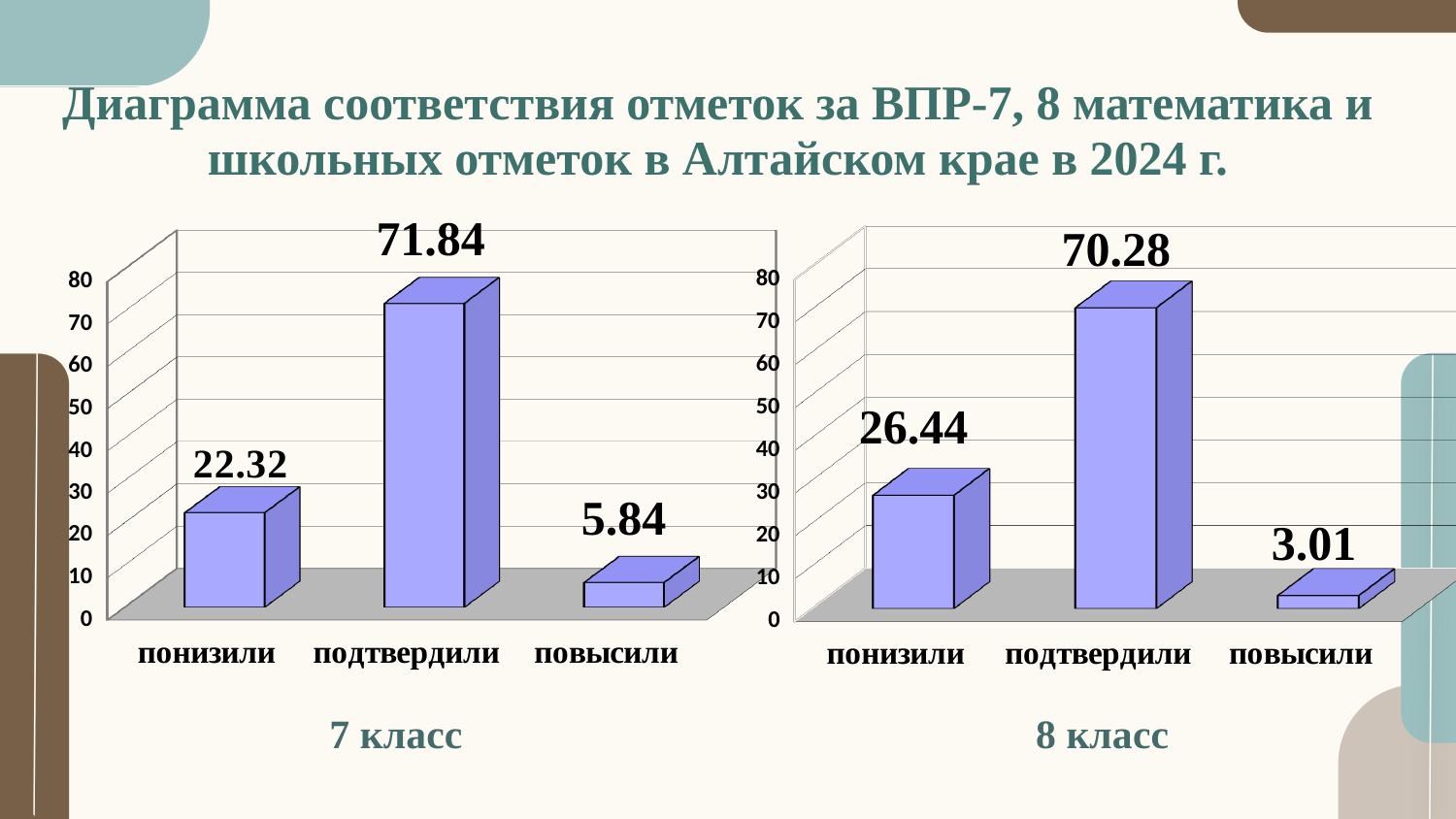
In the right chart (8 класс), which category has the lowest value? повысили In the left chart (7 класс), what is the difference between подтвердили and понизили? 49.52 In the left chart (7 класс), which category has the highest value? подтвердили In the left chart (7 класс), what is the value for понизили? 22.32 In the left chart (7 класс), what is the value for подтвердили? 71.84 How many categories does the left chart (7 класс) show? 3 What kind of chart is the right chart (8 класс)? bar chart How many charts are on the slide? 2 In the right chart (8 класс), what is the value for повысили? 3.01 In the right chart (8 класс), what is the value for понизили? 26.44 Which is larger: понизили in the left chart (7 класс) or понизили in the right chart (8 класс)? 8 класс (26.44) In the right chart (8 класс), what is the difference between понизили and повысили? 23.43